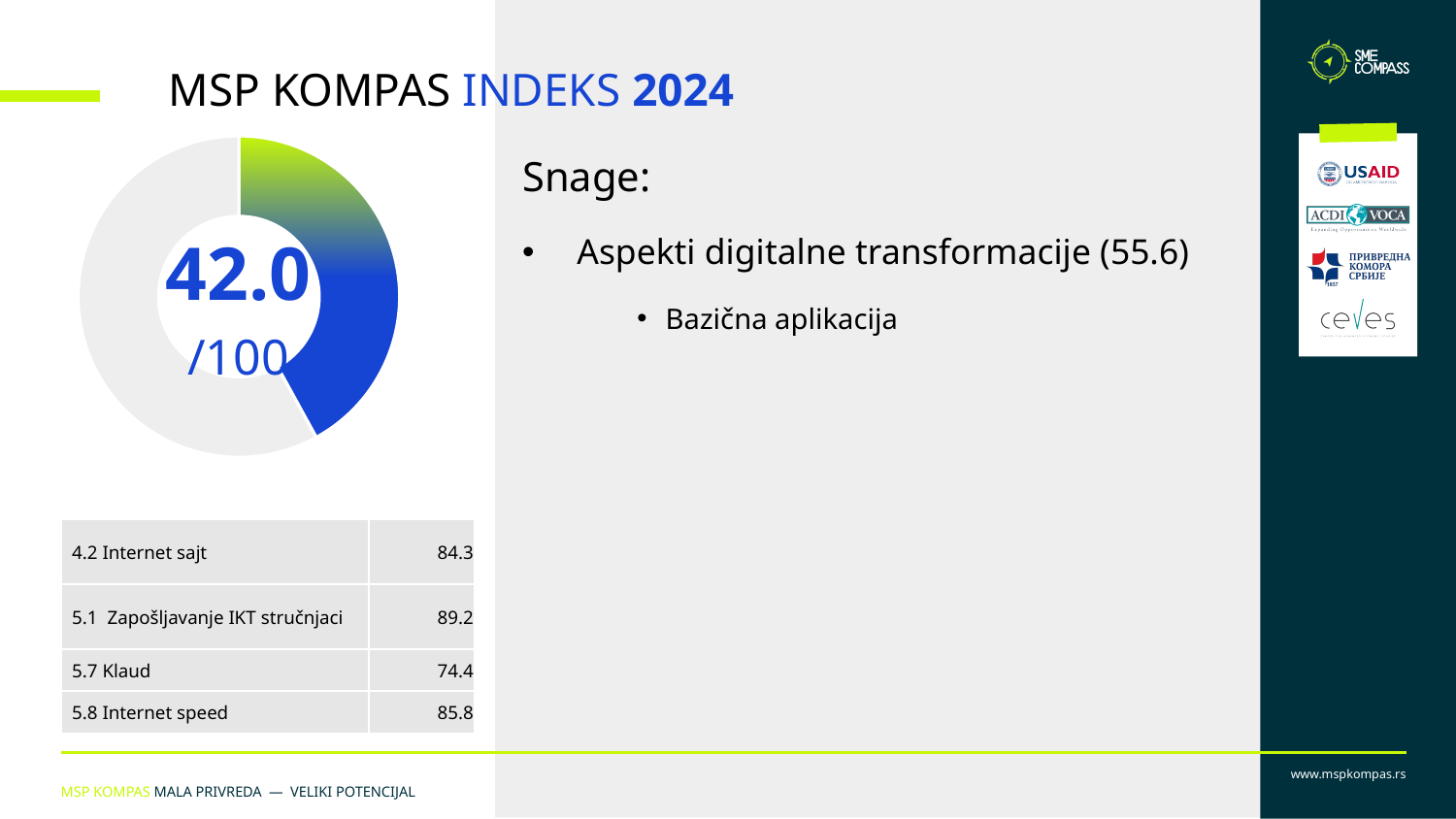
What type of chart is shown on the left of the slide? Donut chart Out of what maximum is the donut chart's value of 42.0 expressed? 100 What is the title of the slide containing the donut chart? MSP KOMPAS INDEKS 2024 Is the value shown in the donut chart greater or less than 50? less Which two colours make up the filled portion of the donut chart? Green and blue What share of the full 100 does the filled portion of the donut chart represent? 42% What value is displayed in the centre of the donut chart? 42.0 How many points out of 100 remain unfilled in the donut chart? 58.0